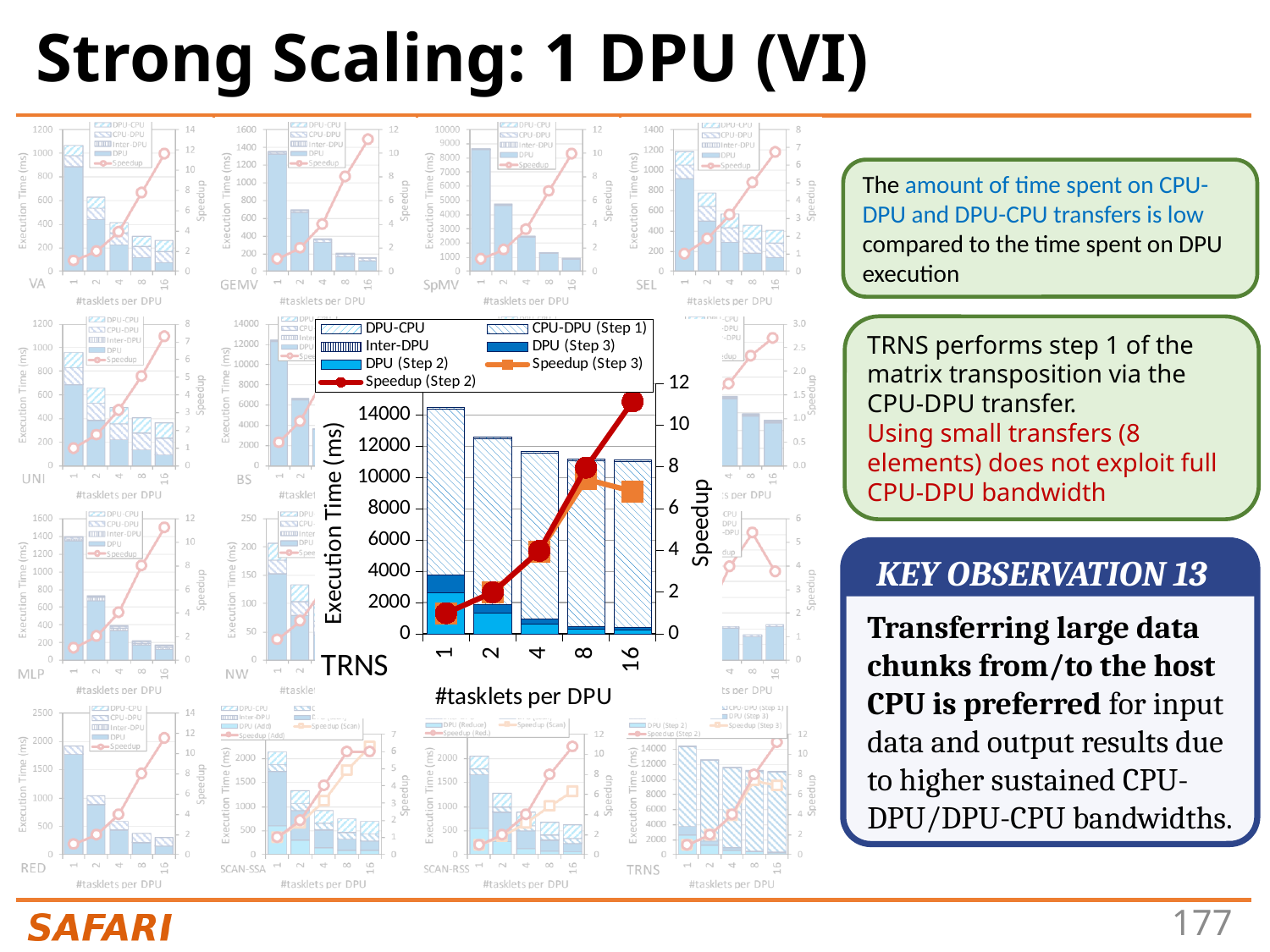
In the enlarged TRNS chart, does the total execution time rise or fall as #tasklets per DPU increases from 1 to 16? fall In the enlarged TRNS chart, is the total execution time at 16 tasklets per DPU greater or less than 12000 ms? less In the enlarged TRNS chart, how many series does the legend list? 7 In the enlarged TRNS chart, at 16 tasklets per DPU, which is larger: Speedup (Step 2) or Speedup (Step 3)? Speedup (Step 2) In the enlarged TRNS chart, is Speedup (Step 2) at 16 tasklets per DPU greater or less than 10? greater In the enlarged TRNS chart, does Speedup (Step 2) rise or fall as #tasklets per DPU increases? rise In the enlarged TRNS chart, which #tasklets per DPU value has the highest total execution time? 1 What is the x-axis label of the enlarged TRNS chart? #tasklets per DPU In the enlarged TRNS chart, what kind of chart is used to show execution time? bar chart (stacked bars with speedup lines) In the enlarged TRNS chart, how many #tasklets per DPU values are plotted on the x axis? 5 In the enlarged TRNS chart, is the total execution time at 2 tasklets per DPU greater or less than 12000 ms? greater